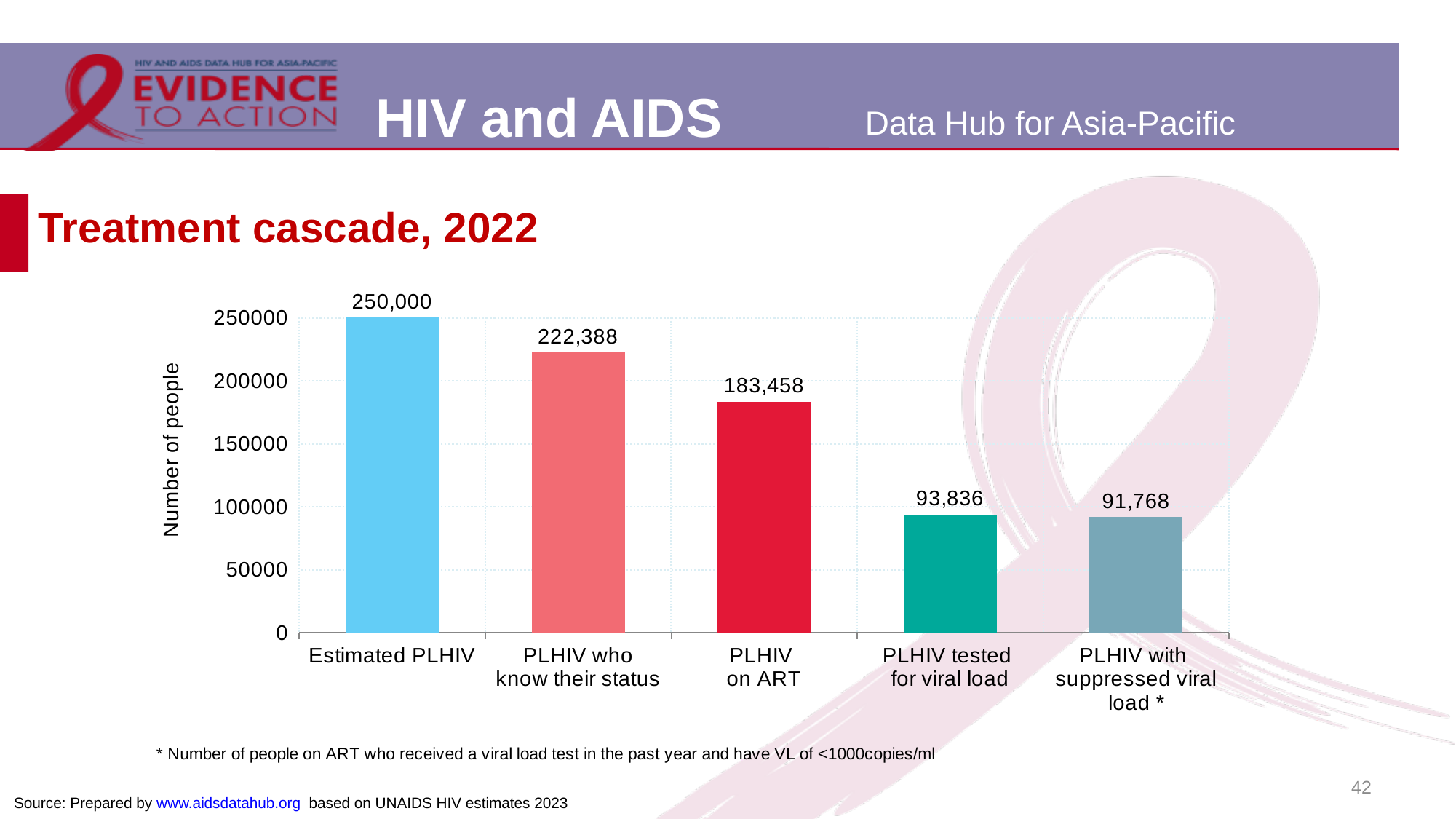
What is the difference between Estimated PLHIV and PLHIV who know their status? 27,612 Which category has the lowest value? PLHIV with suppressed viral load What is the value for PLHIV on ART? 183,458 How many PLHIV know their status according to the chart? 222,388 What is the difference between PLHIV on ART and PLHIV tested for viral load? 89,622 Which category has the highest value? Estimated PLHIV Which is larger: PLHIV tested for viral load or PLHIV with suppressed viral load? PLHIV tested for viral load What is the value for Estimated PLHIV? 250,000 What is the value for PLHIV tested for viral load? 93,836 Do the values rise or fall from left to right along the x axis? fall What is the value for PLHIV with suppressed viral load? 91,768 How many categories are shown in the chart? 5